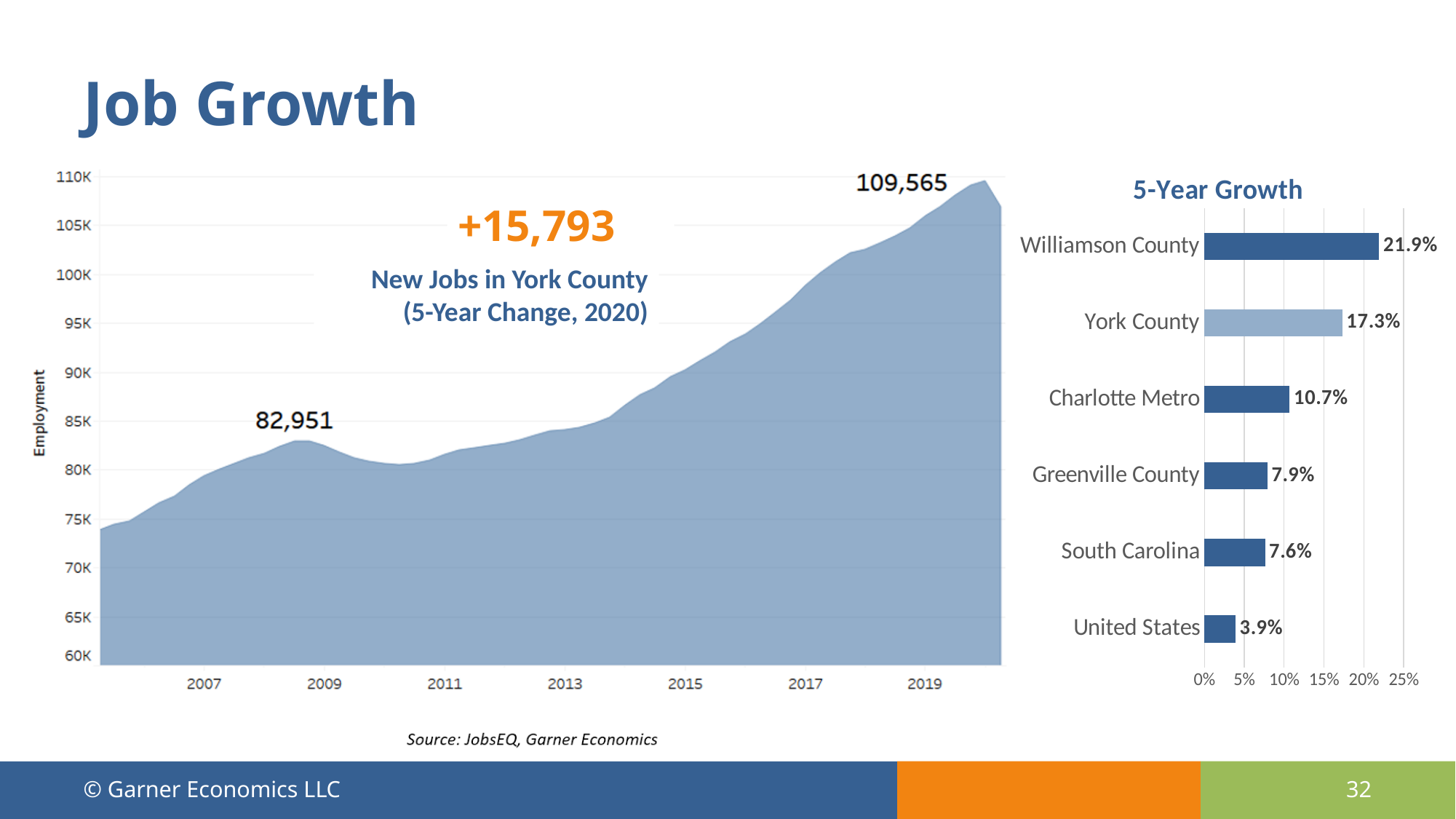
In the employment chart on the left, what is the labeled peak value near 2020? 109,565 In the 5-Year Growth bar chart, what is the difference between Williamson County and York County? 4.6% In the 5-Year Growth bar chart, which is larger, Greenville County or South Carolina? Greenville County In the employment chart on the left, what is the difference between the two labeled values, 109,565 and 82,951? 26,614 In the 5-Year Growth bar chart, which category has the lowest value? United States How many categories are shown in the 5-Year Growth bar chart? 6 In the 5-Year Growth bar chart, what is the value for York County? 17.3% In the employment chart on the left, is the value in 2015 greater or less than 85K? greater In the employment chart on the left, what is the label on the vertical axis? Employment In the 5-Year Growth bar chart, what is the value for Charlotte Metro? 10.7% In the 5-Year Growth bar chart, which category has the highest value? Williamson County What kind of chart is the 5-Year Growth chart on the right? Bar chart